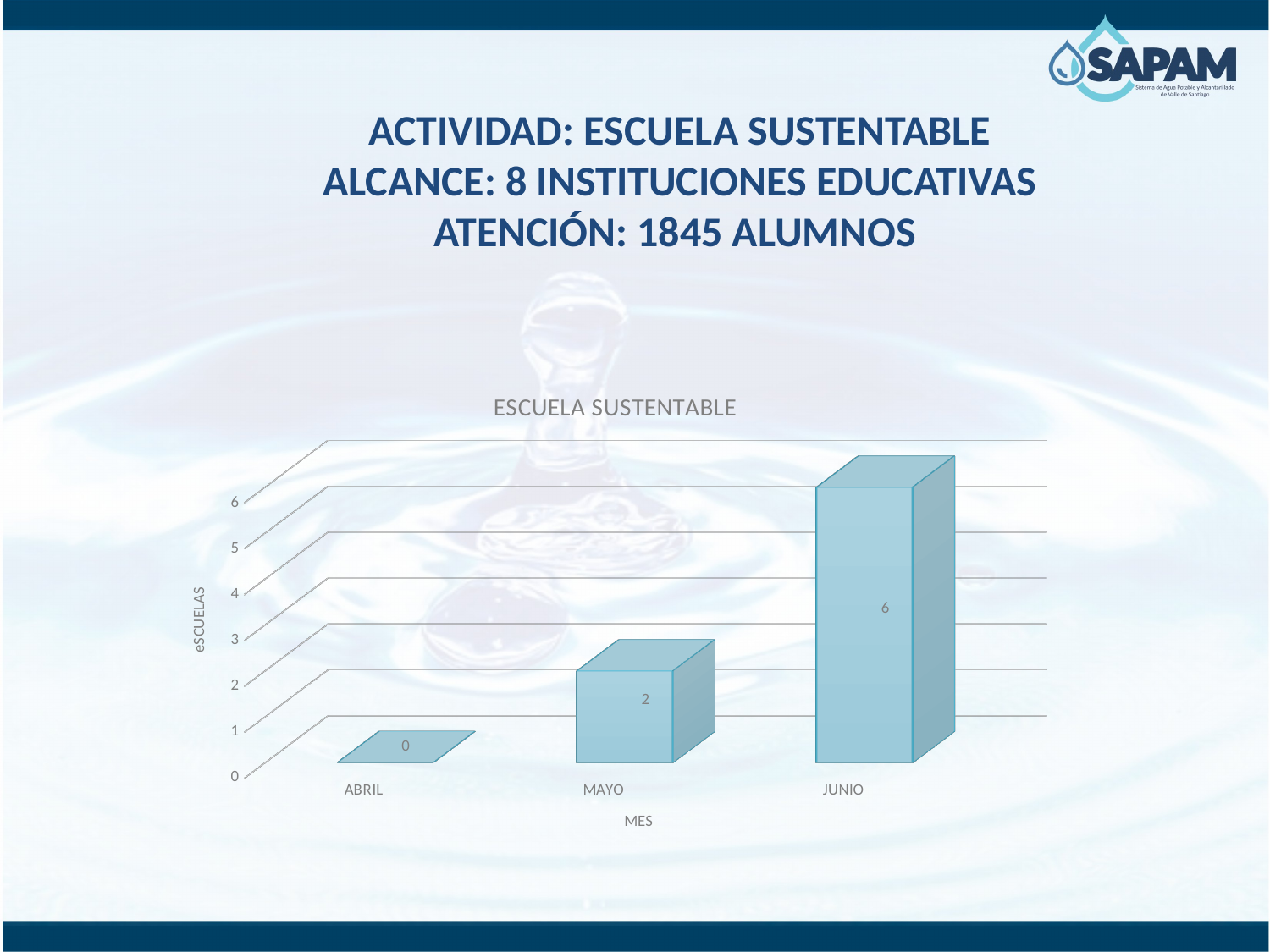
What is the value for MAYO in the ESCUELA SUSTENTABLE chart? 2 What is the difference between the values for JUNIO and MAYO in the ESCUELA SUSTENTABLE chart? 4 What is the value for JUNIO in the ESCUELA SUSTENTABLE chart? 6 Which month has the highest value in the ESCUELA SUSTENTABLE chart? JUNIO Which is larger in the ESCUELA SUSTENTABLE chart, the value for MAYO or the value for JUNIO? JUNIO What is the title of the chart on the slide? ESCUELA SUSTENTABLE What kind of chart is the ESCUELA SUSTENTABLE chart? Bar chart What is the value for ABRIL in the ESCUELA SUSTENTABLE chart? 0 What is the label of the x axis in the ESCUELA SUSTENTABLE chart? MES How many months are shown on the x axis of the ESCUELA SUSTENTABLE chart? 3 Do the values in the ESCUELA SUSTENTABLE chart rise or fall from ABRIL to JUNIO? Rise Which month has the lowest value in the ESCUELA SUSTENTABLE chart? ABRIL